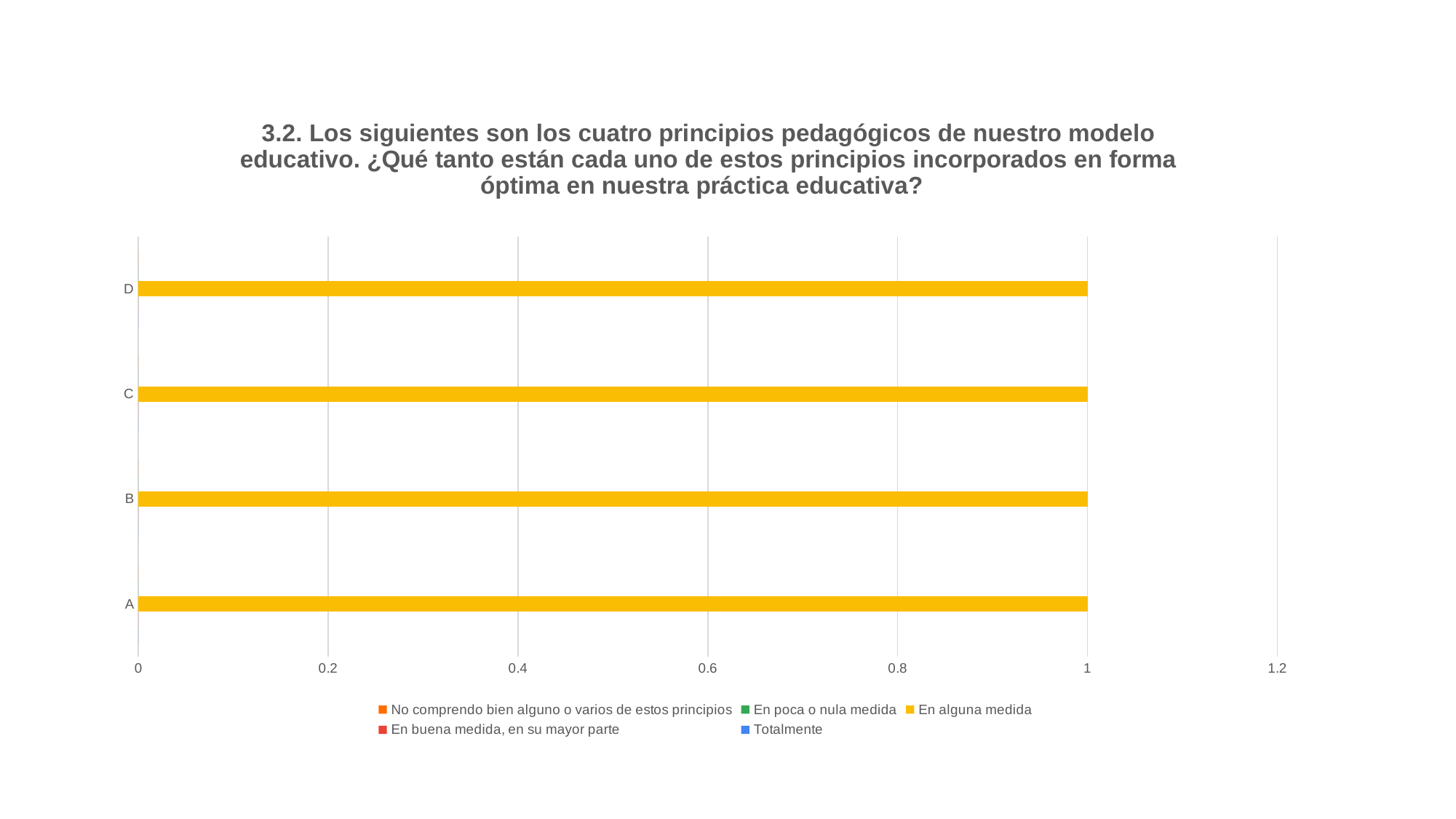
Is the value for category B greater or less than 0.8? greater How many series does the chart's legend list? 5 How many categories are shown on the vertical axis of the chart? 4 What is the value of the 'En alguna medida' bar for category C? 1 What is the highest value shown on the horizontal axis of the chart? 1.2 What kind of chart is shown on the slide? bar chart What is the value of the 'En alguna medida' bar for category A? 1 What is the difference between the 'En alguna medida' values for categories A and D? 0 Is the value for category C greater or less than 1.2? less What is the value of the 'En alguna medida' bar for category D? 1 Which legend series do the visible bars in the chart belong to? En alguna medida